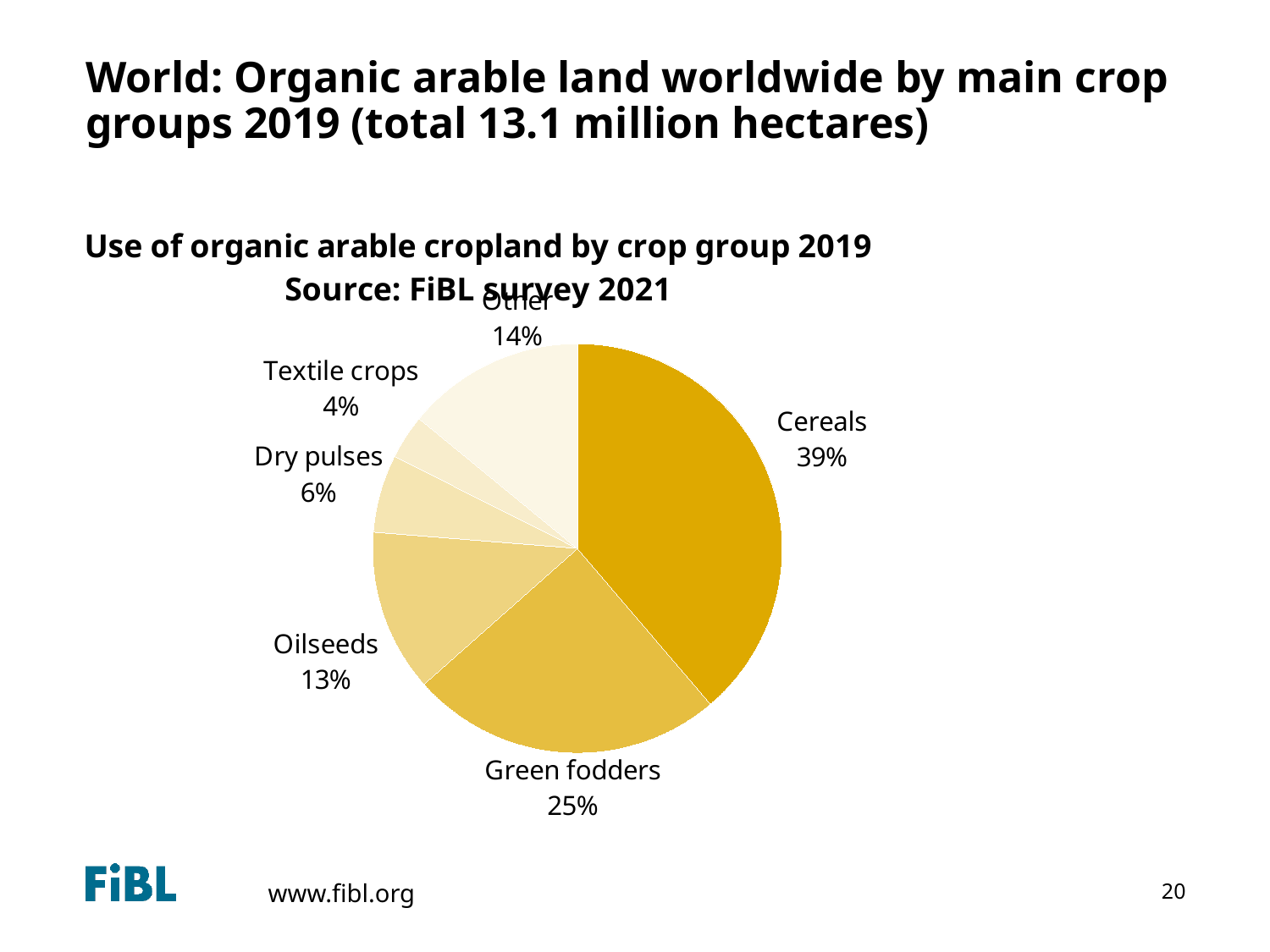
What is the difference in percentage points between Cereals and Green fodders? 14 What type of chart is shown on the slide? Pie chart Which crop group has the largest share of the pie? Cereals What percentage does the Textile crops slice represent? 4% Which crop group has the smallest share of the pie? Textile crops What percentage does the Dry pulses slice represent? 6% What is the title of the chart? Use of organic arable cropland by crop group 2019 Source: FiBL survey 2021 What share of organic arable cropland is used for Green fodders? 25% How many crop groups are shown in the pie chart? 6 What percentage does the Oilseeds slice represent? 13% Which is larger, the share for Other or the share for Oilseeds? Other What share of organic arable cropland is used for Cereals? 39%